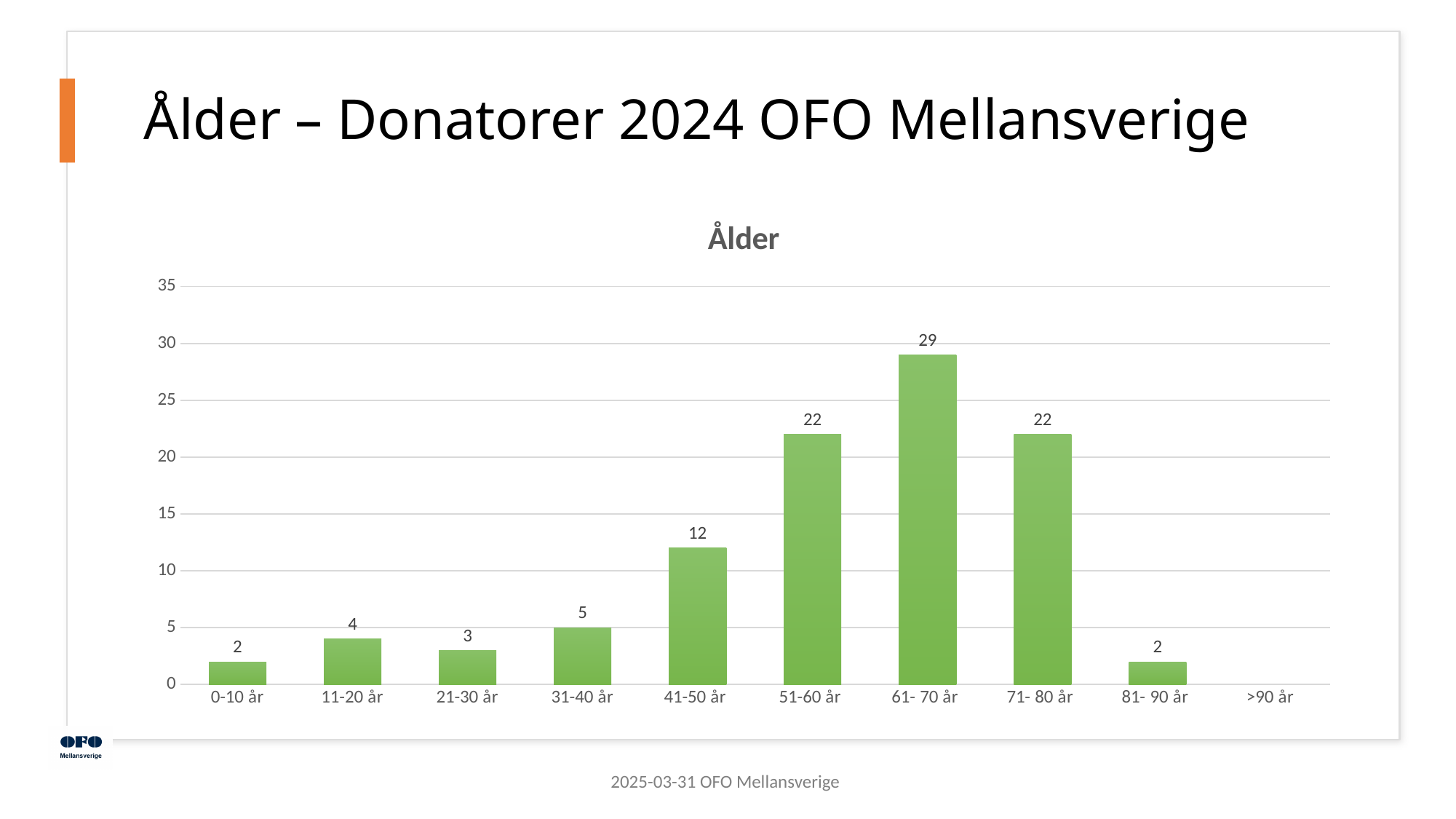
How many age categories are shown on the x axis? 10 Which age category has the highest value? 61- 70 år What is the value for the 41-50 år category? 12 What colour are the bars in the chart? green What kind of chart is shown on the slide? bar chart Which is larger, the value for 11-20 år or the value for 21-30 år? 11-20 år What is the difference between the values for 41-50 år and 31-40 år? 7 What is the difference between the values for 61- 70 år and 51-60 år? 7 What is the value for the 61- 70 år category? 29 Is the value for 71- 80 år greater or less than 20? greater What is the title of the chart? Ålder What is the value for the 31-40 år category? 5